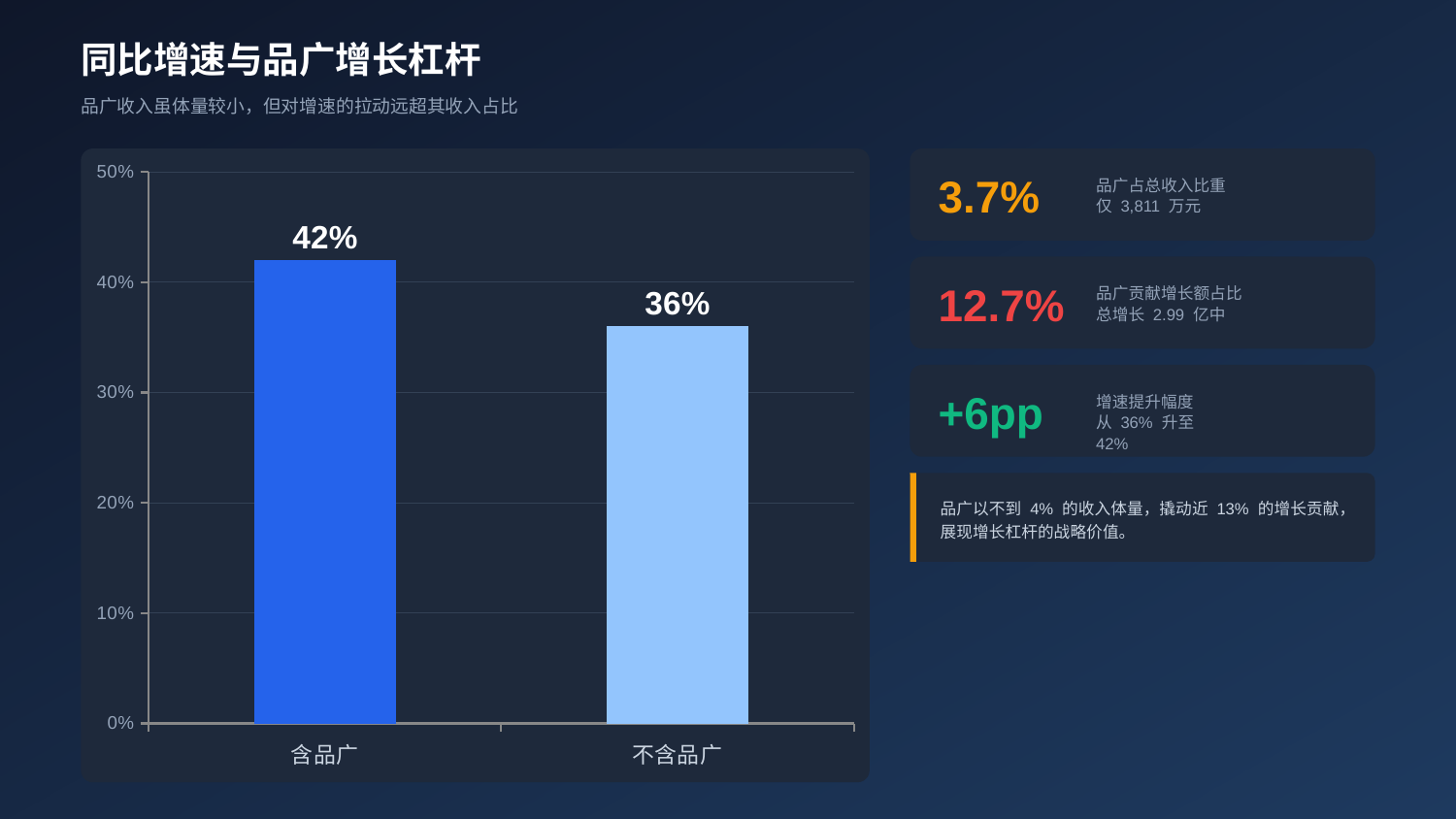
Which is larger, the value for 含品广 or the value for 不含品广? 含品广 How many categories are shown on the x axis? 2 What is the maximum value shown on the y axis? 50% Do the values rise or fall from left to right along the x axis? fall Is the value for 不含品广 greater or less than 40%? less What is the difference between the values for 含品广 and 不含品广? 6% Which category has the highest value? 含品广 What kind of chart is shown on the slide? bar chart Is the value for 含品广 greater or less than 40%? greater What is the value for 含品广? 42% Which category has the lowest value? 不含品广 What is the value for 不含品广? 36%